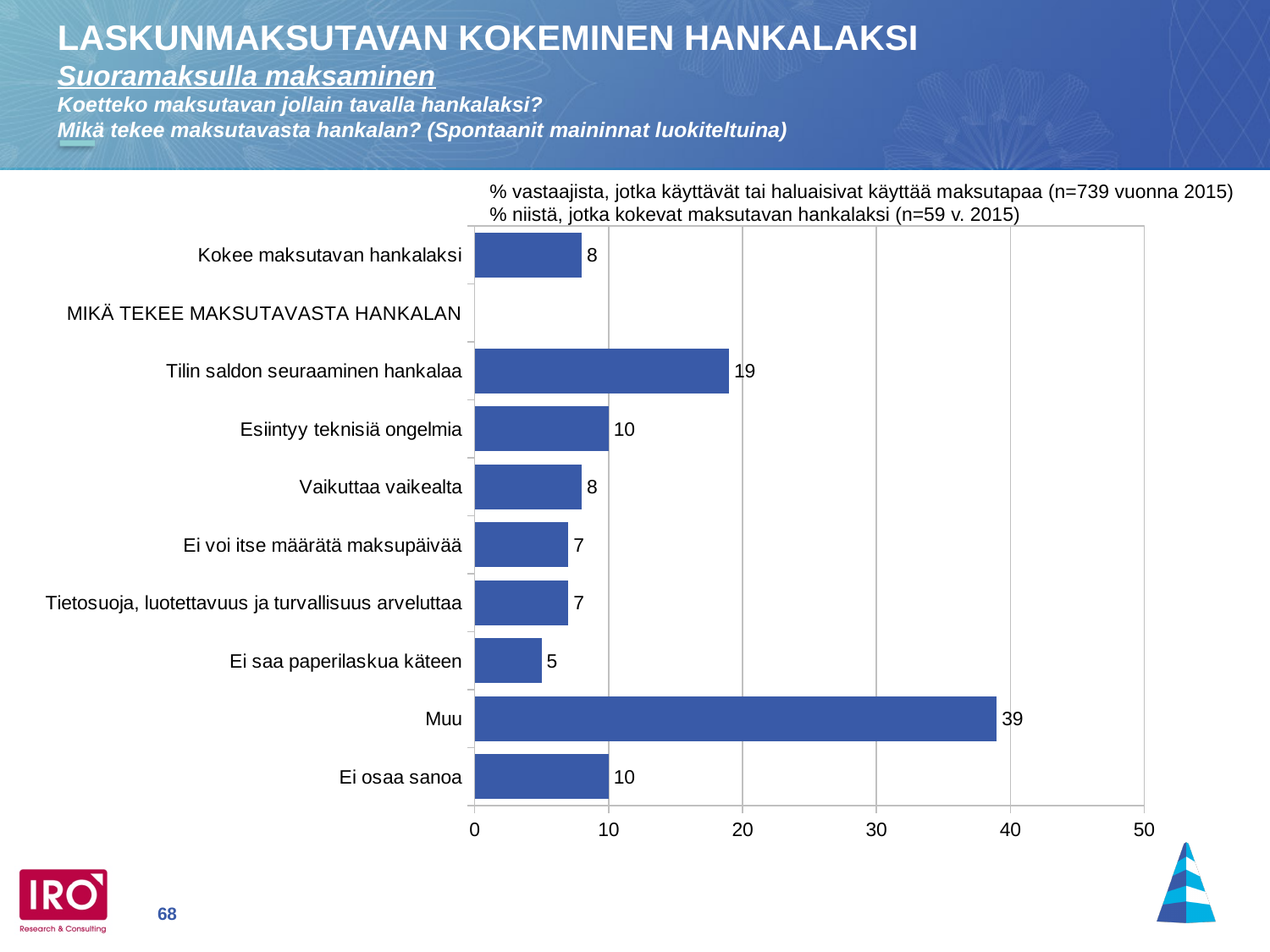
What is the value for "Kokee maksutavan hankalaksi"? 8 How many bars are plotted in the chart? 9 What kind of chart is shown on the slide? bar chart Is the value for "Muu" greater or less than 30? greater Which is larger, the value for "Tilin saldon seuraaminen hankalaa" or for "Esiintyy teknisiä ongelmia"? Tilin saldon seuraaminen hankalaa What is the value for "Ei saa paperilaskua käteen"? 5 Which category has the highest value? Muu What is the value for "Muu"? 39 What is the value for "Tilin saldon seuraaminen hankalaa"? 19 What is the difference between the values for "Tilin saldon seuraaminen hankalaa" and "Esiintyy teknisiä ongelmia"? 9 Which category has the lowest value? Ei saa paperilaskua käteen What is the difference between the values for "Muu" and "Tilin saldon seuraaminen hankalaa"? 20